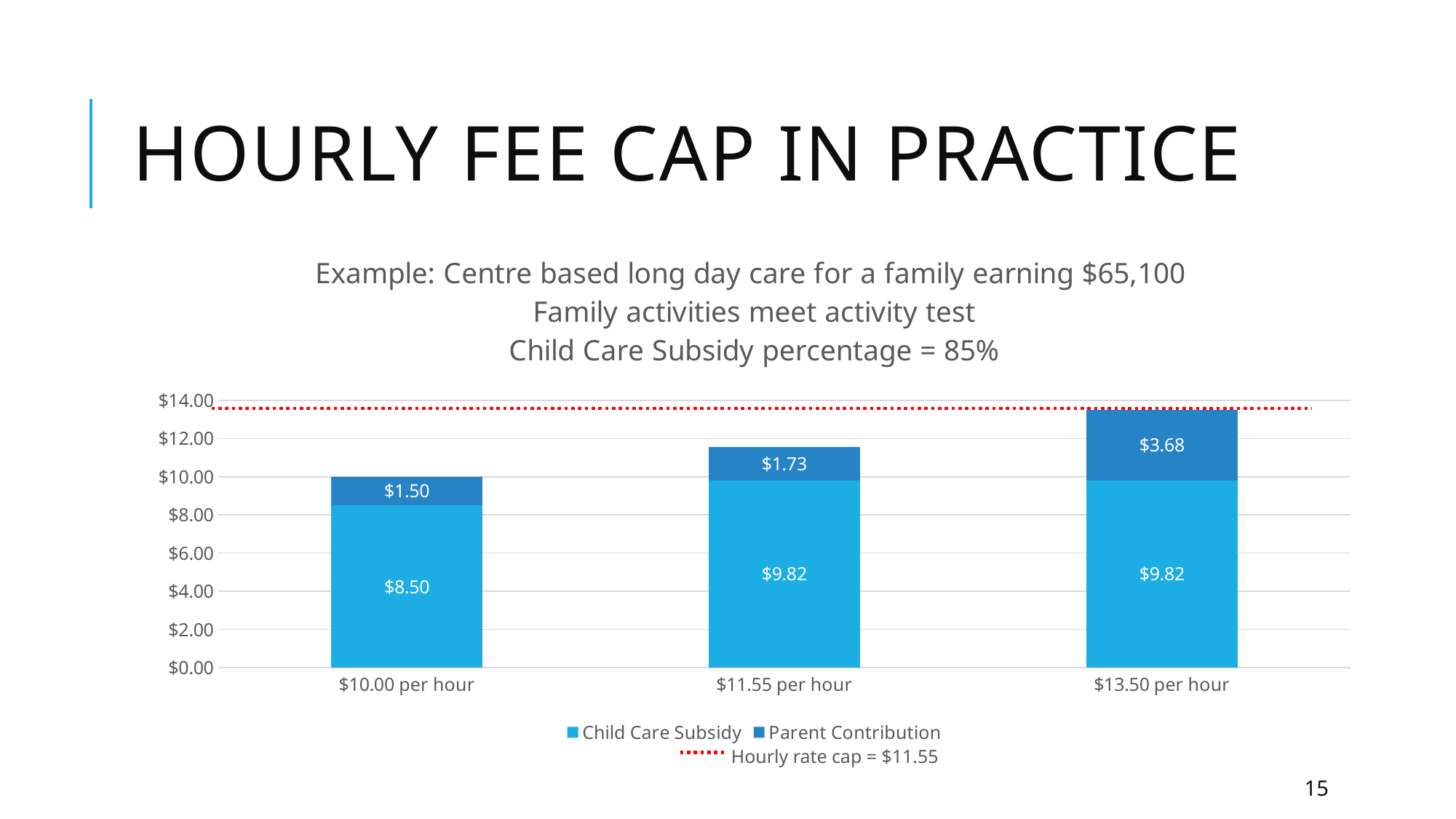
What is the Parent Contribution value for the $11.55 per hour bar? $1.73 What is the Child Care Subsidy value for the $10.00 per hour bar? $8.50 What is the Parent Contribution value for the $13.50 per hour bar? $3.68 Is the Child Care Subsidy larger for $10.00 per hour or for $11.55 per hour? $11.55 per hour What kind of chart is shown on the slide? Stacked bar chart Which category has the highest Parent Contribution? $13.50 per hour What is the difference between the Parent Contribution for $13.50 per hour and for $11.55 per hour? $1.95 Which category has the lowest Child Care Subsidy? $10.00 per hour How many entries does the legend list? 3 How many categories are shown on the x axis? 3 What value does the red dotted line in the legend represent? Hourly rate cap = $11.55 What is the total of the stacked bar for $13.50 per hour? $13.50